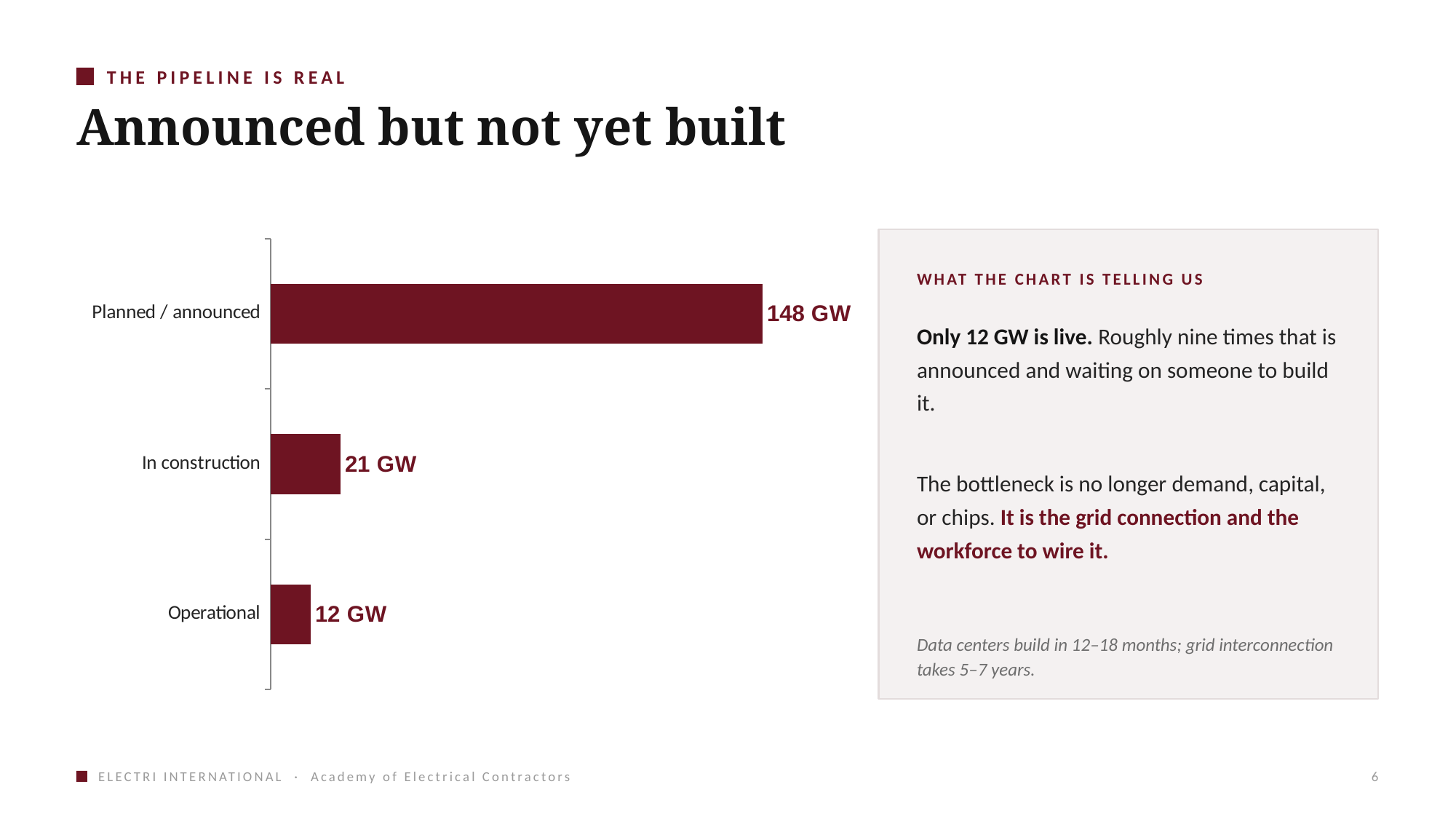
What is the value for Planned / announced? 148 GW What is the difference between the Planned / announced value and the Operational value? 136 GW Which category has the highest value? Planned / announced Which category has the lowest value? Operational What kind of chart is shown on the slide? Bar chart What is the value for In construction? 21 GW What is the total of the three values shown in the chart? 181 GW What is the title of the slide containing the chart? Announced but not yet built What is the difference between the In construction value and the Operational value? 9 GW What is the value for Operational? 12 GW Which is larger, the value for In construction or the value for Operational? In construction How many categories are shown in the chart? 3